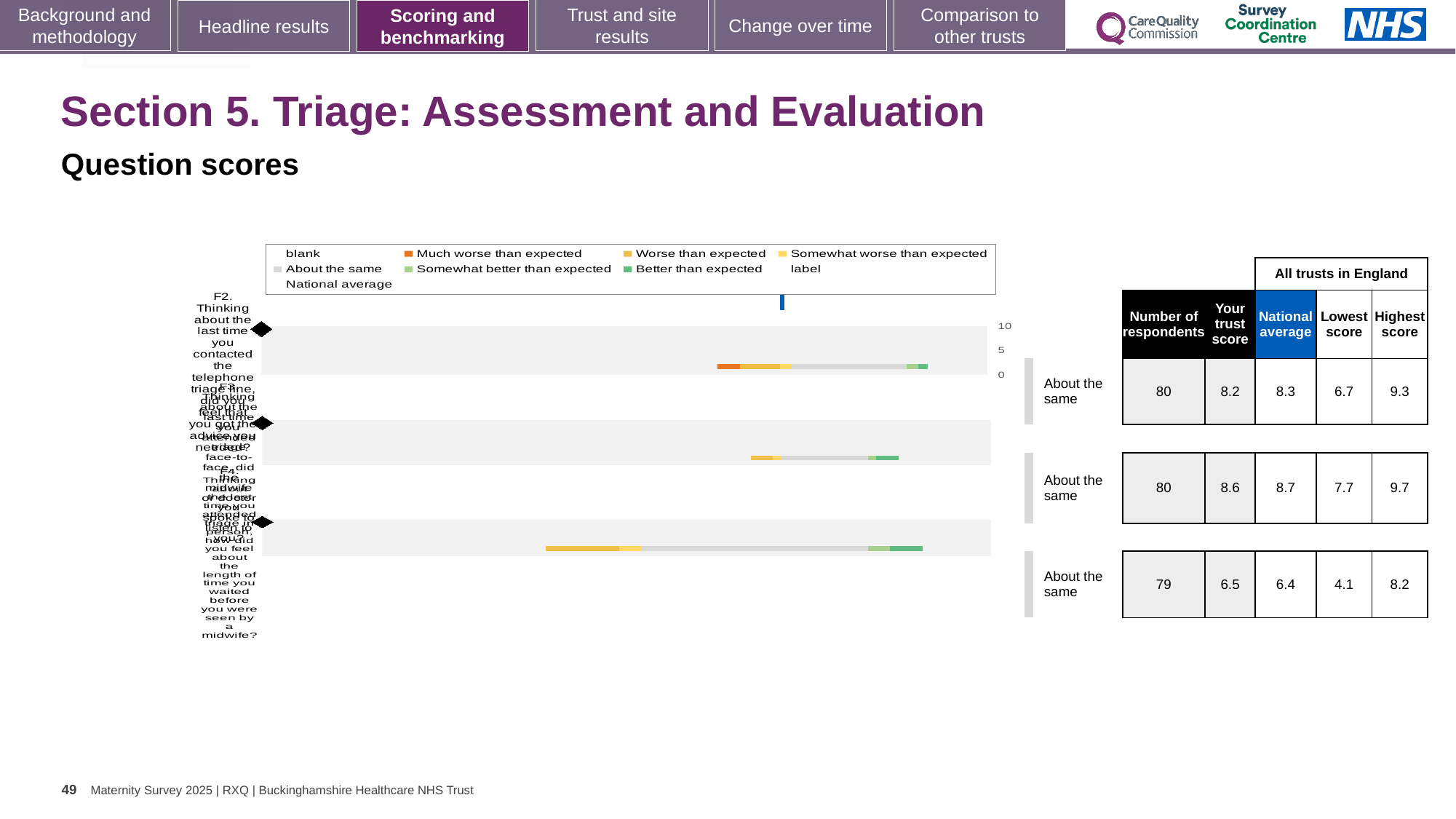
How many entries does the chart legend list? 9 In the table beside the chart, what is 'Your trust score' for the third question row? 6.5 What colour represents 'Much worse than expected' in the chart legend? orange What colour represents 'Better than expected' in the chart legend? green For the third question row, which is larger: 'Your trust score' or the national average? Your trust score What is the highest tick value shown on the chart's score axis? 10 For the third question row, what is the difference between the highest score and the lowest score in the table? 4.1 Which question row has the highest 'Your trust score' in the table? the second row (8.6) How many question rows (bars) are plotted in the chart? 3 What kind of chart is shown on the slide? bar chart In the table beside the chart, what is the number of respondents for the first question row? 80 In the table beside the chart, what is the national average for the second question row? 8.7